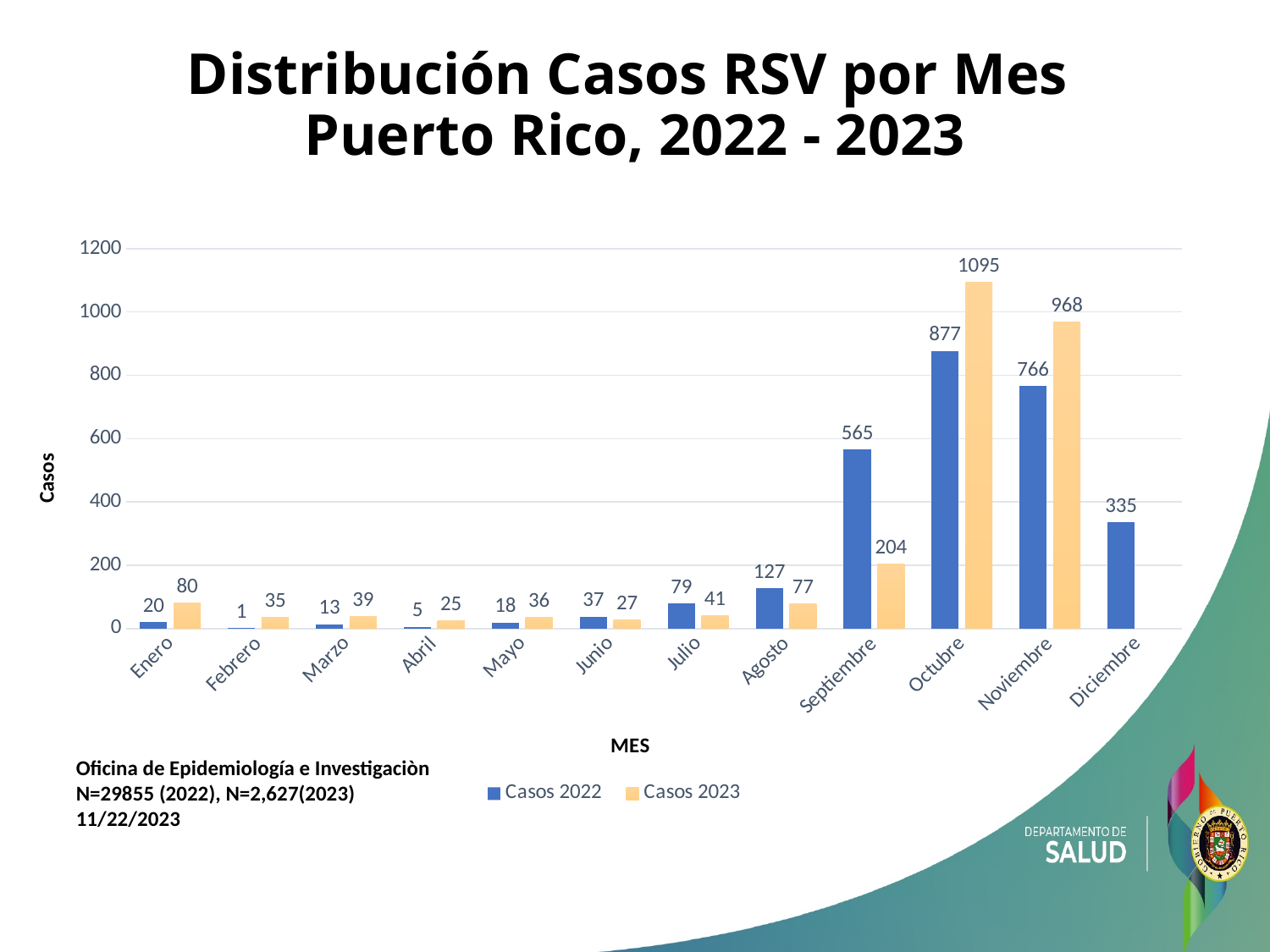
What kind of chart is shown on the slide? bar chart Which month has the highest value for Casos 2023? Octubre How many months are shown on the x axis? 12 What is the label of the y axis? Casos What is the value for Casos 2023 in Noviembre? 968 Which is larger in Septiembre, Casos 2022 or Casos 2023? Casos 2022 What is the value for Casos 2022 in Diciembre? 335 What is the difference between Casos 2023 and Casos 2022 in Octubre? 218 Which month has the lowest value for Casos 2022? Febrero What is the value for Casos 2022 in Octubre? 877 Is the value for Casos 2022 in Noviembre greater or less than 800? less How many series does the legend list? 2